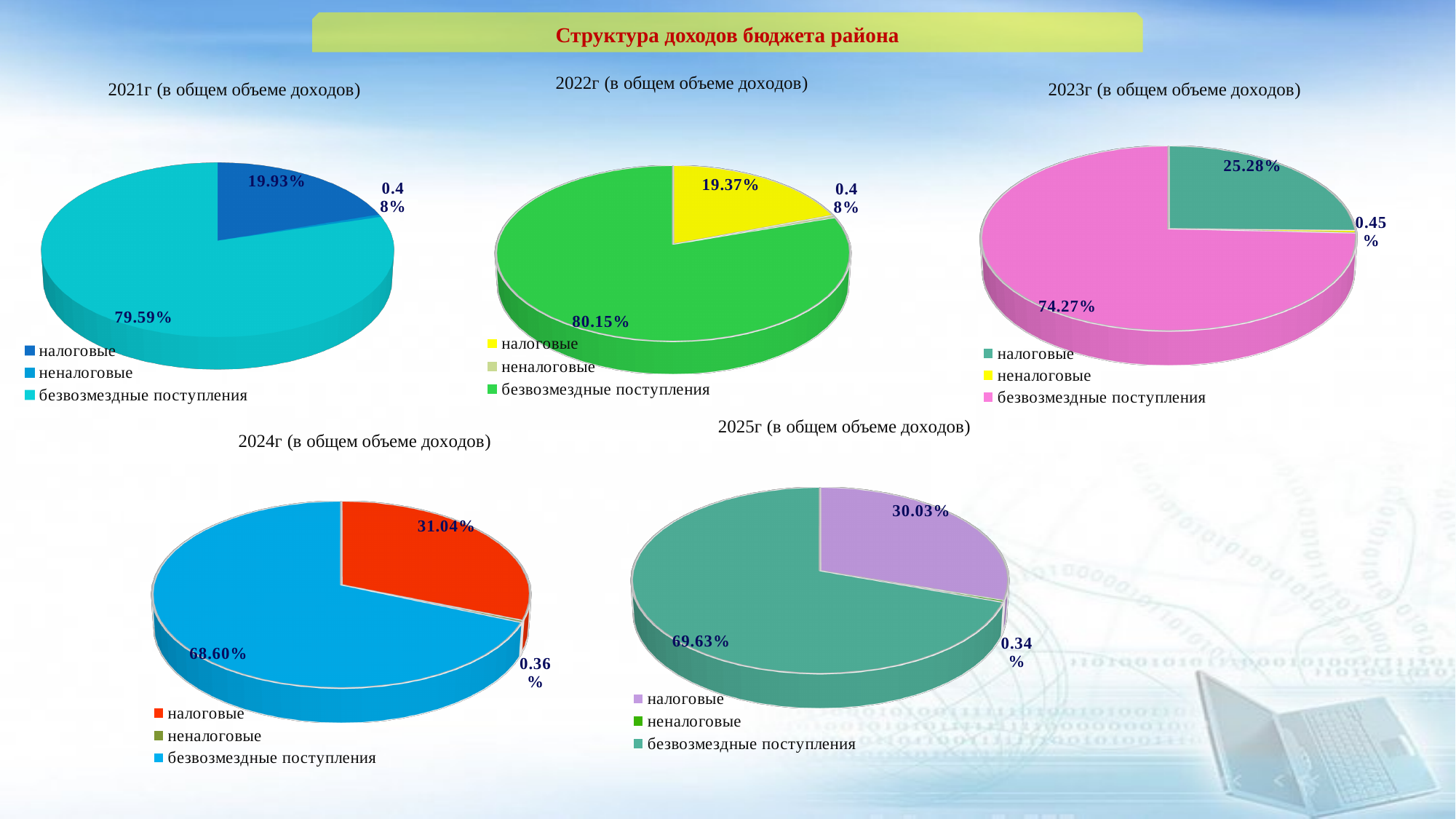
How many charts are shown on the slide? 5 In the 2025г chart, what is the difference between безвозмездные поступления and налоговые? 39.60% In the 2021г chart, what share of total income is безвозмездные поступления? 79.59% How many categories does the legend of the 2022г chart list? 3 In the 2025г chart, what is the value for безвозмездные поступления? 69.63% In the 2022г chart, what is the value for налоговые? 19.37% In the 2023г chart, which category has the largest share? безвозмездные поступления In the 2024г chart, which category has the smallest share? неналоговые In the 2023г chart, what is the value for неналоговые? 0.45% Which is larger: налоговые in the 2024г chart or налоговые in the 2025г chart? 2024г In the 2024г chart, what is the value for налоговые? 31.04% What type of chart is used for the 2021г data? pie chart